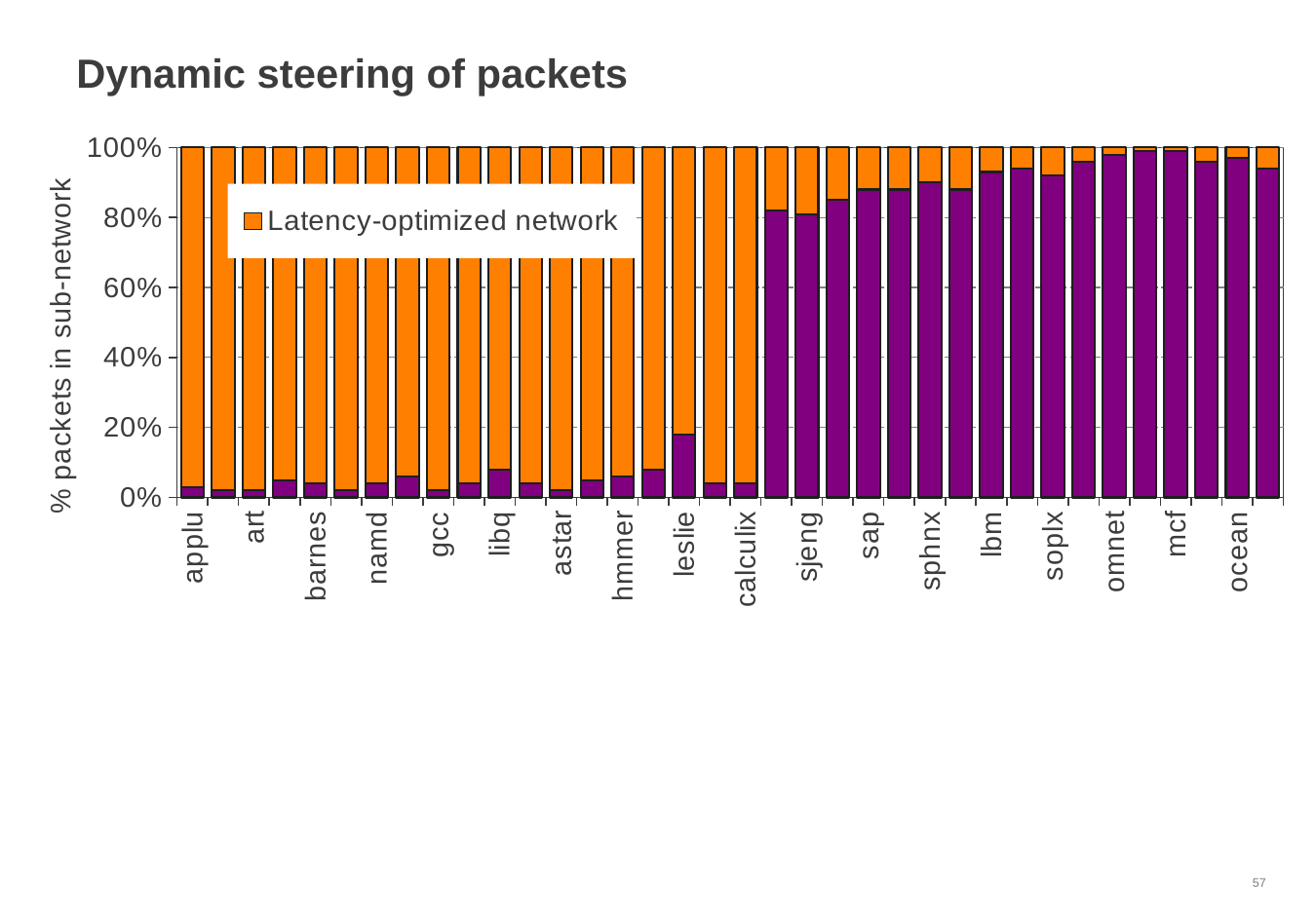
How many series does the legend list? 1 Which has a larger Latency-optimized network (orange) portion, applu or sjeng? applu What is the title of the chart? Dynamic steering of packets Is the purple (bottom) portion of the bar for leslie greater or less than 20%? less Is the purple (bottom) portion of the bar for calculix greater or less than 20%? less How many category labels are shown along the x axis? 18 Is the purple (bottom) portion of the bar for omnet greater or less than 90%? greater What is the label on the vertical axis of the chart? % packets in sub-network What kind of chart is shown on the slide? stacked bar chart Which has a larger purple (bottom) portion, leslie or libq? leslie